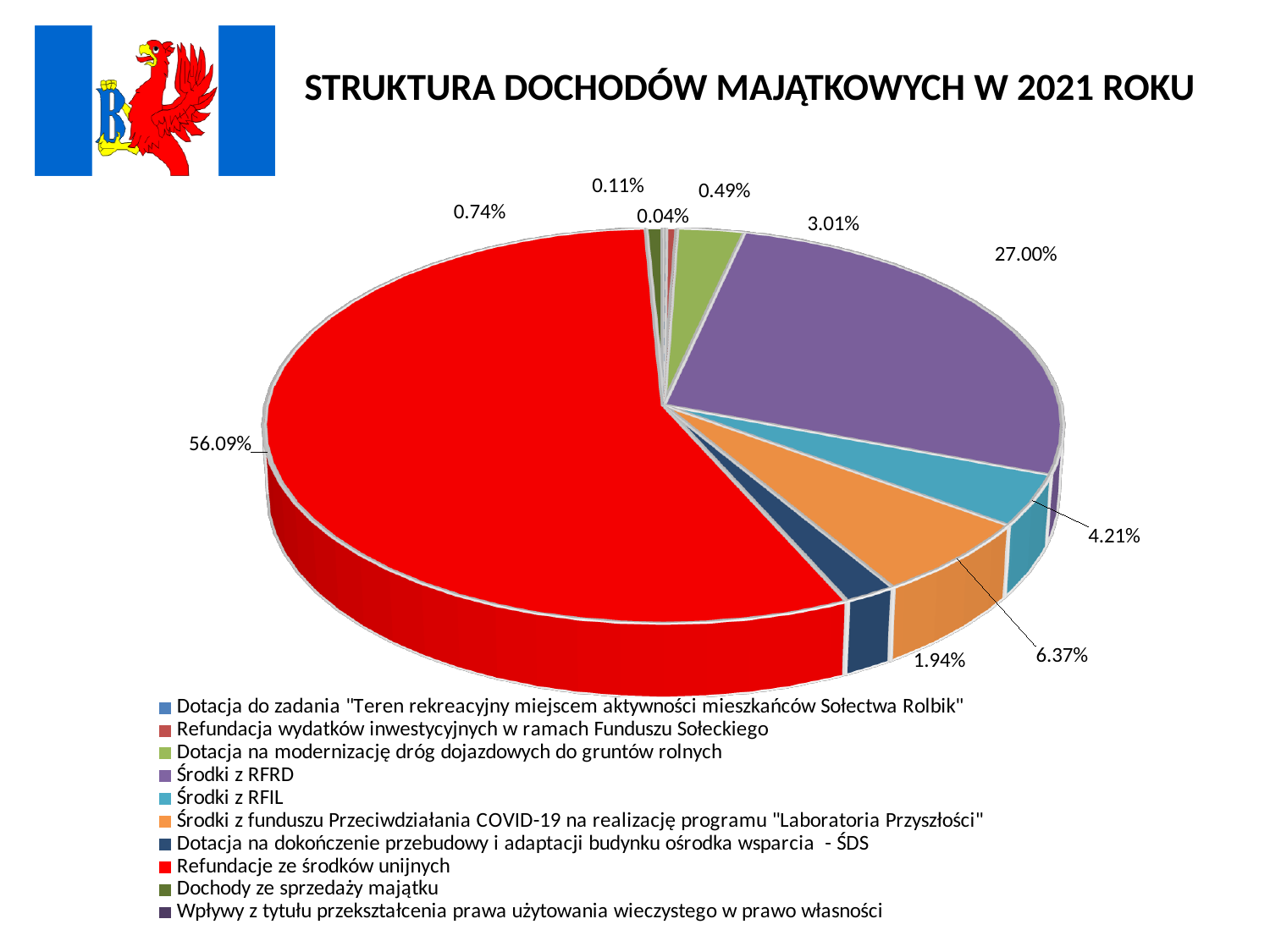
What share of the pie is "Środki z RFRD"? 27.00% Which is larger, the share for "Środki z RFRD" or the share for "Środki z RFIL"? Środki z RFRD By how many percentage points does "Refundacje ze środków unijnych" exceed "Środki z RFRD"? 29.09 What kind of chart is shown on the slide? pie chart What share of the pie is "Refundacje ze środków unijnych"? 56.09% How many categories does the legend list? 10 Which category has the largest share of the pie? Refundacje ze środków unijnych What share of the pie is "Środki z RFIL"? 4.21% What is the title of the chart? STRUKTURA DOCHODÓW MAJĄTKOWYCH W 2021 ROKU What is the smallest percentage labelled on the pie? 0.04%